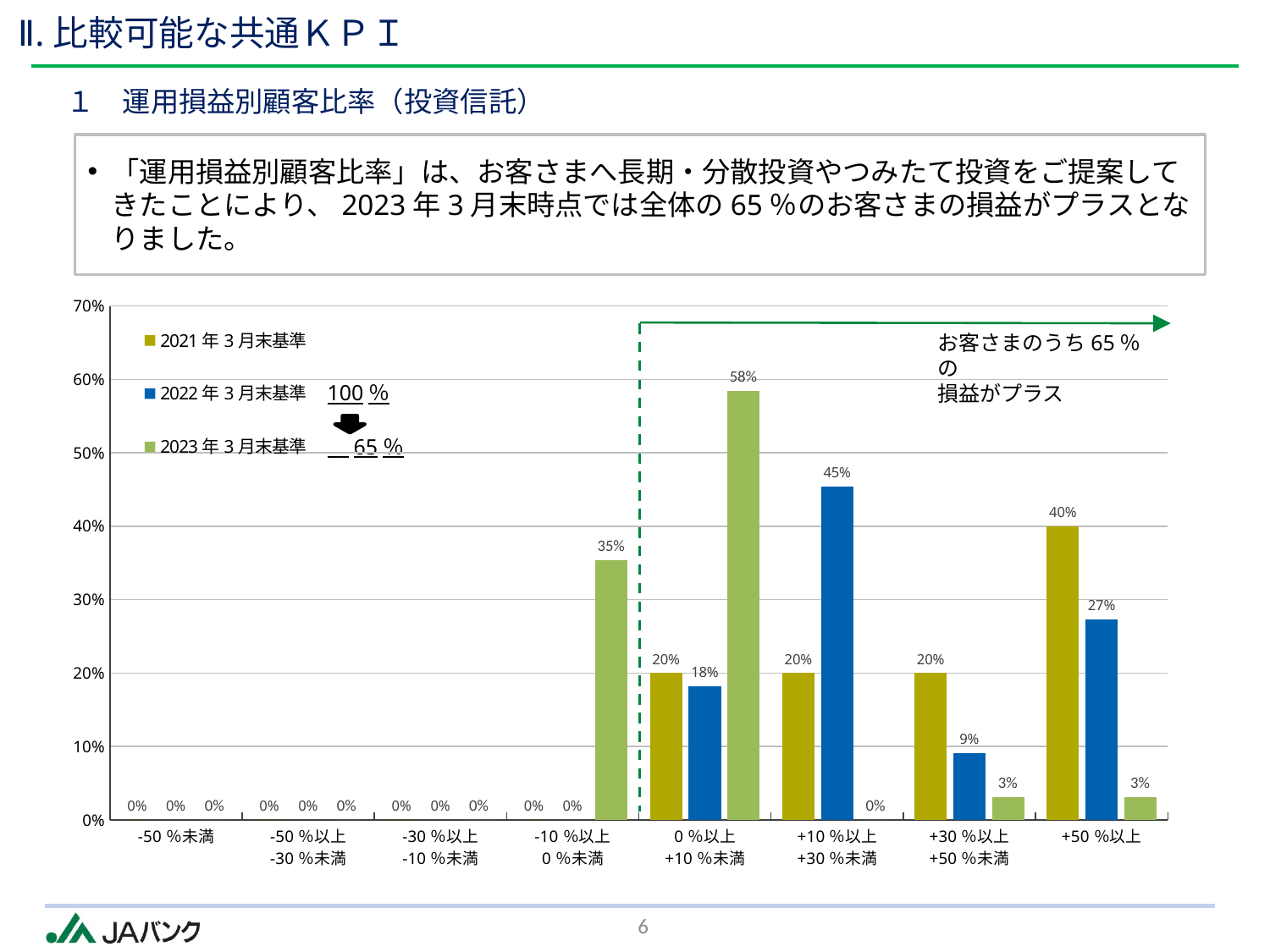
What is the value for 2021年3月末基準 in the +50%以上 category? 40% What is the value for 2023年3月末基準 in the 0%以上+10%未満 category? 58% What kind of chart is shown on the slide? bar chart How many categories are shown on the x axis? 8 What is the value for 2022年3月末基準 in the +30%以上+50%未満 category? 9% Which legend entry is shown in light green? 2023年3月末基準 In the 0%以上+10%未満 category, which is larger: the 2021年3月末基準 value or the 2022年3月末基準 value? 2021年3月末基準 How many series does the legend list? 3 What is the value for 2022年3月末基準 in the +10%以上+30%未満 category? 45% Which category has the highest value for the 2022年3月末基準 series? +10%以上+30%未満 What is the value for 2023年3月末基準 in the -10%以上0%未満 category? 35% What is the difference between the 2021年3月末基準 and 2022年3月末基準 values in the +50%以上 category? 13%